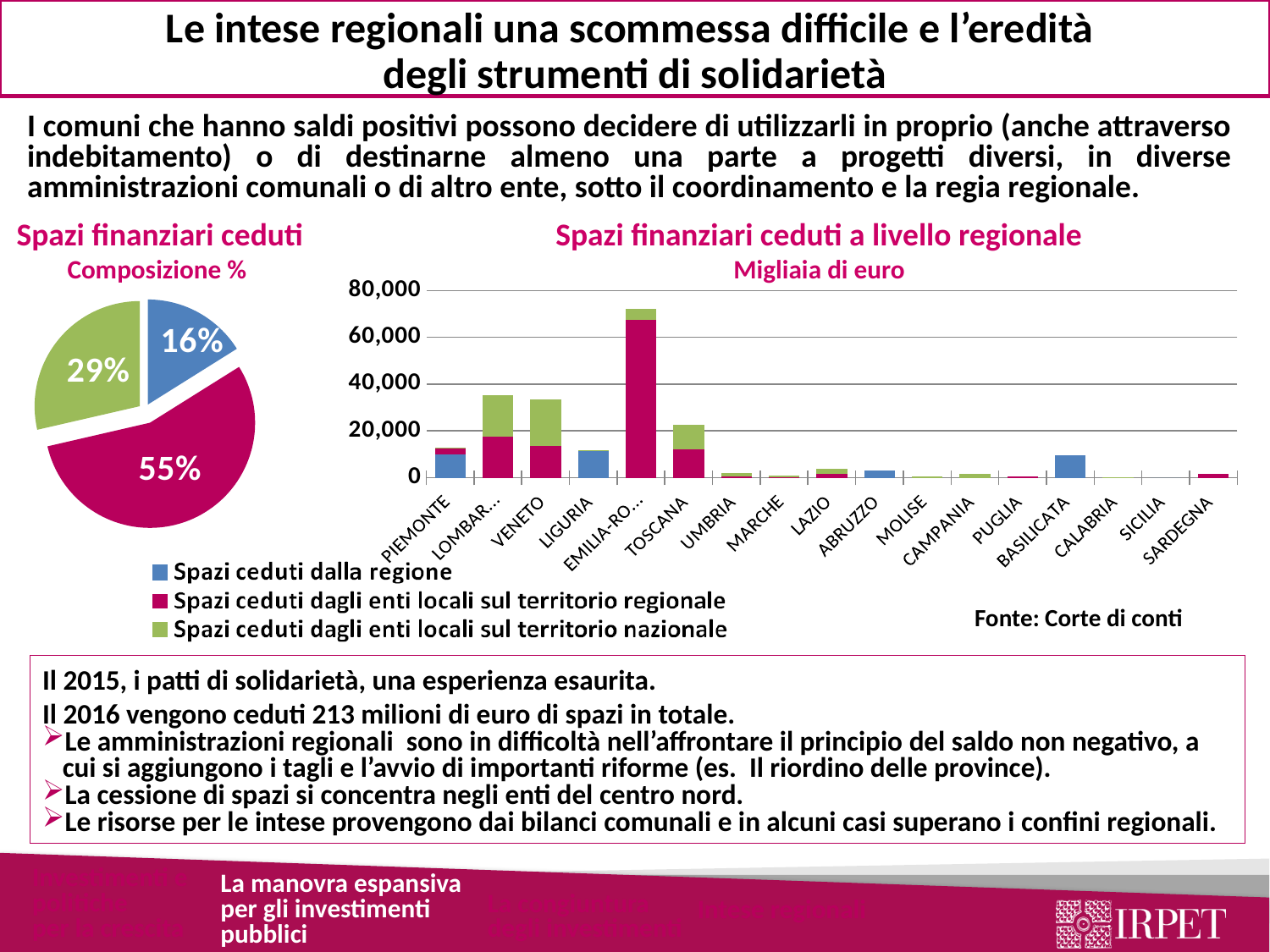
In the pie chart 'Spazi finanziari ceduti', what share is shown for the green slice? 29% In the pie chart 'Spazi finanziari ceduti', what is the difference in percentage points between the largest slice (55%) and the smallest slice (16%)? 39 In the bar chart 'Spazi finanziari ceduti a livello regionale', is the total for VENETO greater or less than 20,000? greater How many series does the legend list for the bar chart 'Spazi finanziari ceduti a livello regionale'? 3 In the bar chart 'Spazi finanziari ceduti a livello regionale', how many regions are shown on the x axis? 17 In the bar chart 'Spazi finanziari ceduti a livello regionale', is the total for EMILIA-ROMAGNA greater or less than 60,000? greater In the pie chart 'Spazi finanziari ceduti', how many slices are there? 3 In the bar chart 'Spazi finanziari ceduti a livello regionale', is the total for PIEMONTE greater or less than 20,000? less In the bar chart 'Spazi finanziari ceduti a livello regionale', which is larger, the total for LIGURIA or the total for TOSCANA? TOSCANA In the bar chart 'Spazi finanziari ceduti a livello regionale', which region has the highest total? EMILIA-ROMAGNA In the pie chart 'Spazi finanziari ceduti', what percentage is shown for the largest slice? 55% In the pie chart 'Spazi finanziari ceduti', what percentage is shown for the smallest slice? 16%